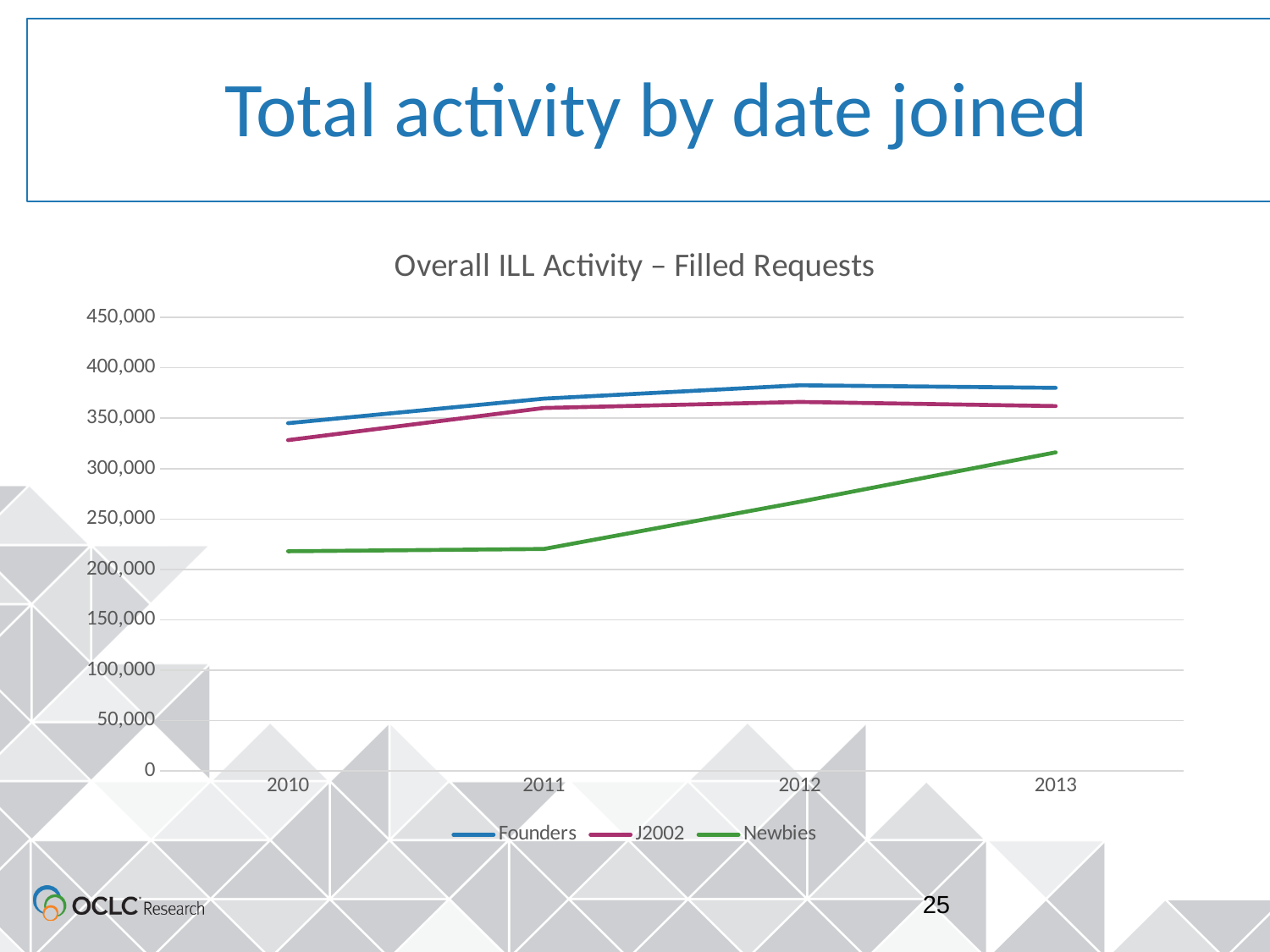
What is the title of the chart? Overall ILL Activity – Filled Requests How many years are shown on the x axis? 4 Is the value for Founders in 2012 greater or less than 350,000? greater Is the value for Newbies in 2010 greater or less than 250,000? less What colour is the Newbies line? green Is the value for Newbies in 2013 greater or less than 300,000? greater Does the Newbies line rise or fall from 2011 to 2013? rise Which series has the highest value in 2010? Founders What kind of chart is shown on the slide? line chart Which series has the lowest value in 2013? Newbies How many series does the legend list? 3 Which is larger in 2011, the value for J2002 or the value for Newbies? J2002